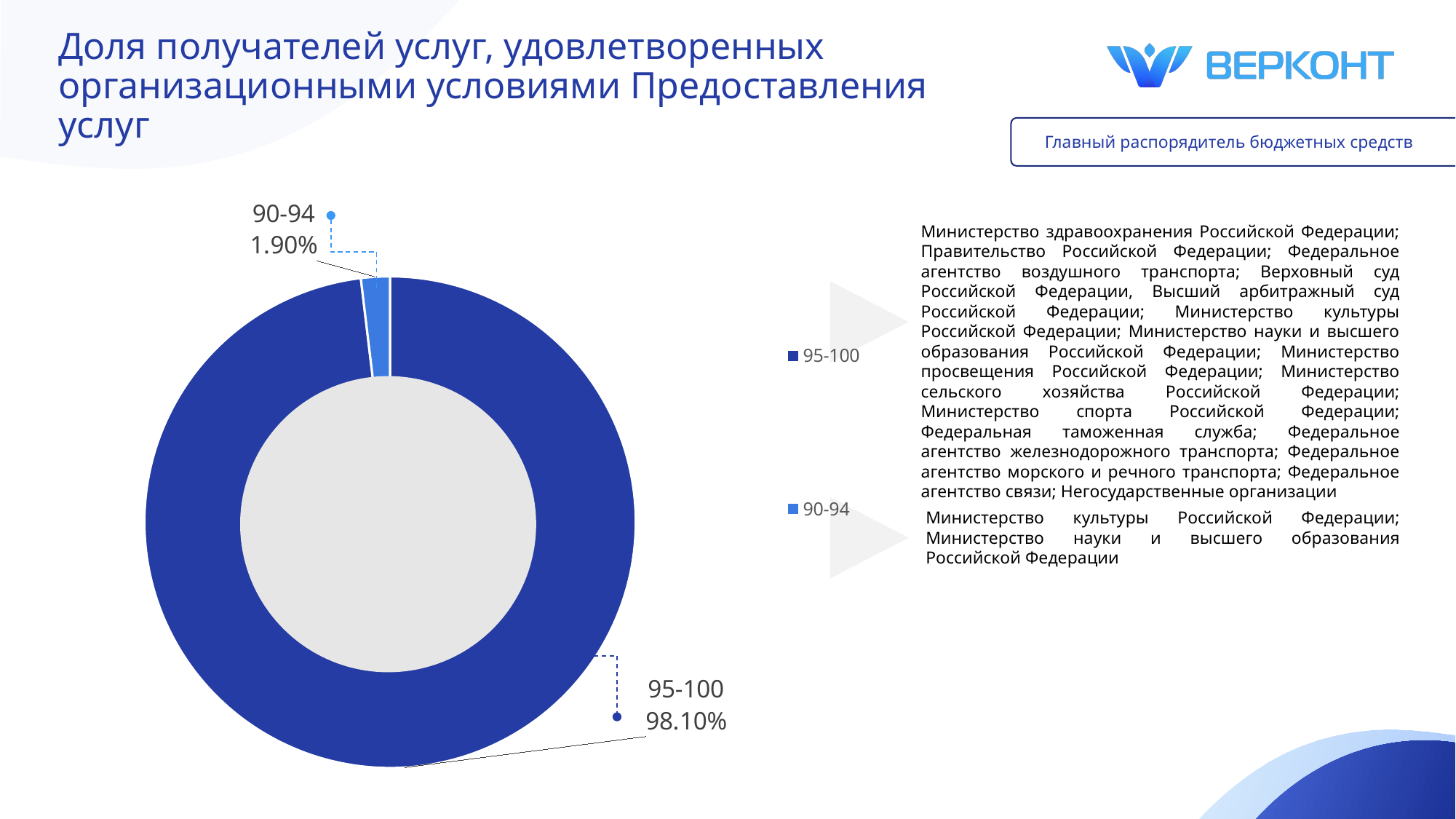
Which category has the largest share of the pie? 95-100 What is the title of the chart on the slide? Доля получателей услуг, удовлетворенных организационными условиями Предоставления услуг What is the difference in percentage points between the 95-100 and 90-94 shares? 96.20 How many categories are shown in the chart? 2 Which category has the smallest share of the pie? 90-94 What share of the pie does the 95-100 category hold? 98.10% What share of the pie does the 90-94 category hold? 1.90% How many entries does the legend list? 2 Which legend entry is shown in the lighter blue colour? 90-94 Which is larger, the share for 95-100 or the share for 90-94? 95-100 What kind of chart is shown on the slide? Pie chart (doughnut) What is the total of the two shares shown in the chart? 100.00%